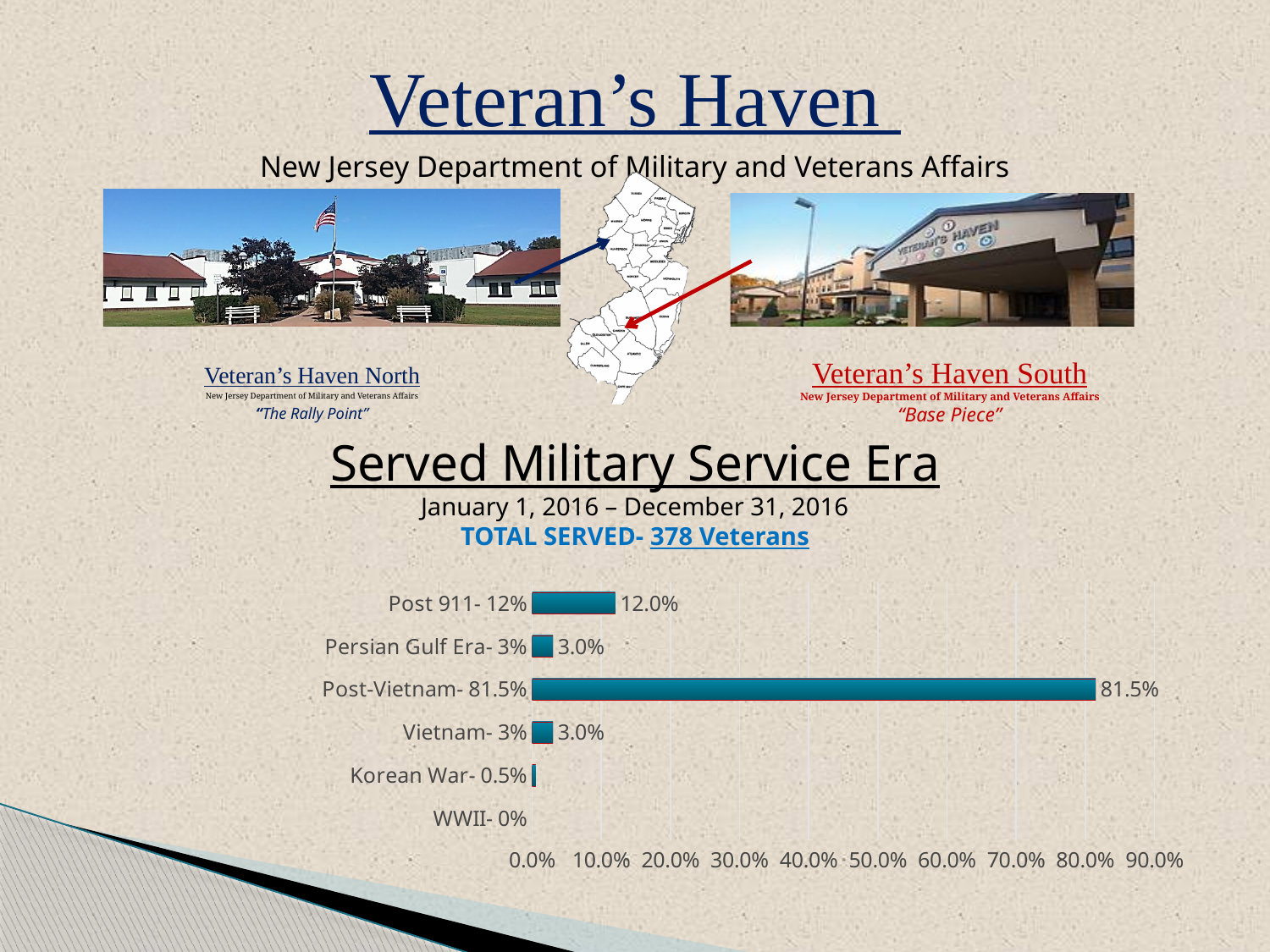
Is the value for Post-Vietnam greater or less than 80.0%? greater What is the value for Persian Gulf Era in the chart? 3.0% What is the difference between the Post-Vietnam value and the Post 911 value? 69.5% Which service era has the lowest value in the chart? WWII What is the value for Post 911 in the Served Military Service Era chart? 12.0% Which service era has the highest value in the chart? Post-Vietnam Which is larger, the value for Post 911 or the value for Vietnam? Post 911 What kind of chart is used to show the Served Military Service Era data? Bar chart What is the value for Post-Vietnam in the Served Military Service Era chart? 81.5% What is the total number of veterans served stated above the chart? 378 Veterans How many service era categories are shown in the chart? 6 What percentage is shown for the Korean War category? 0.5%